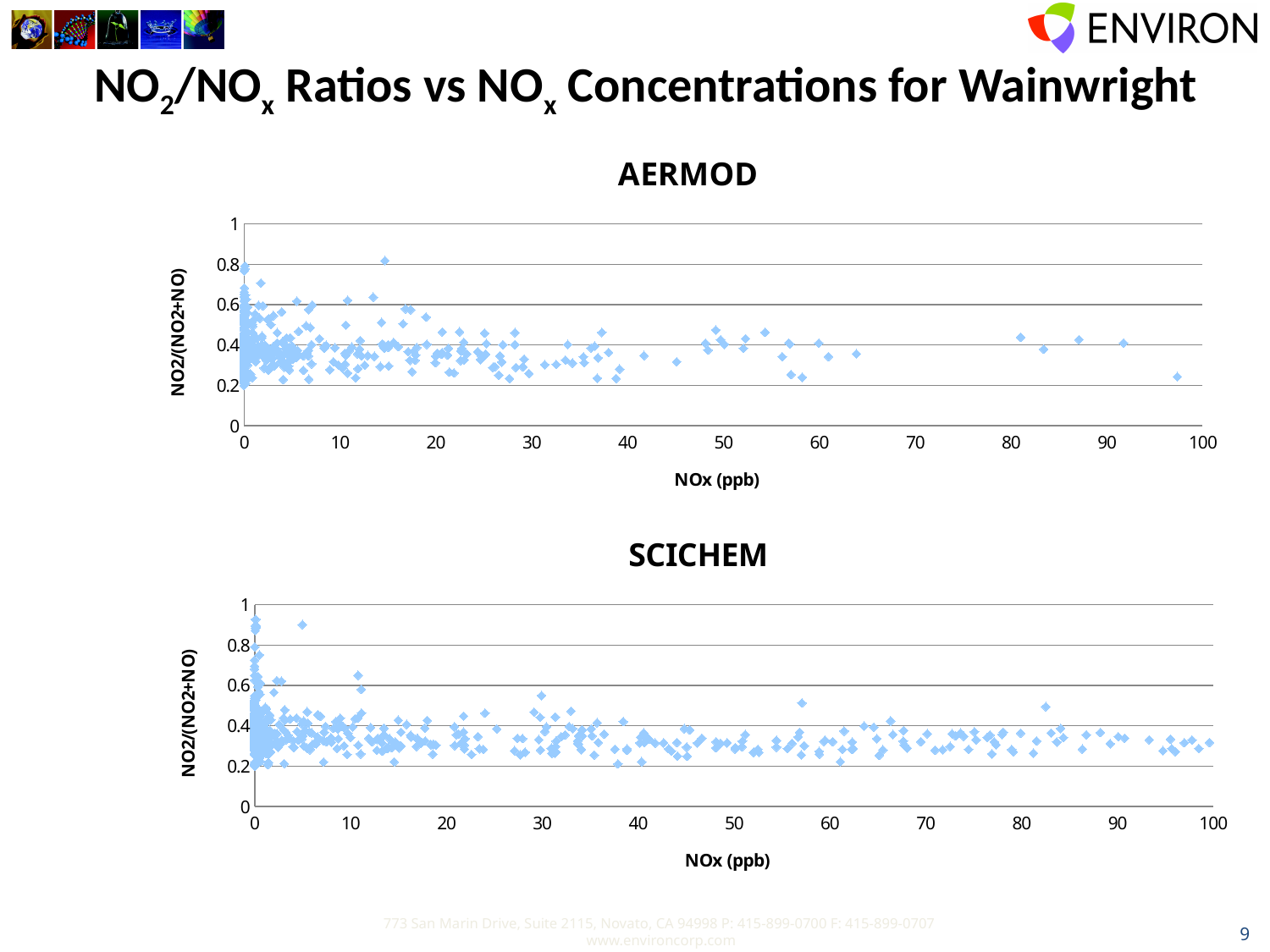
In the SCICHEM chart, are the points with NOx above 60 ppb generally greater or less than 0.6? less In the SCICHEM chart, does the spread of ratio values widen or narrow as NOx increases along the x axis? narrow What kind of chart is the AERMOD chart? scatter chart In the AERMOD chart, is the ratio for the rightmost point (near 97 ppb NOx) greater or less than 0.4? less How many data series are plotted in the SCICHEM chart? 1 In the AERMOD chart, is the highest point near 15 ppb NOx higher or lower than the rightmost point near 97 ppb? higher How many charts are shown on the slide? 2 What are the titles of the two charts on the slide? AERMOD and SCICHEM In the AERMOD chart, does the number of plotted points increase or decrease as NOx increases? decrease What is the y-axis label on the SCICHEM chart? NO2/(NO2+NO) In the AERMOD chart, is the ratio for the point near 81 ppb NOx greater or less than 0.6? less